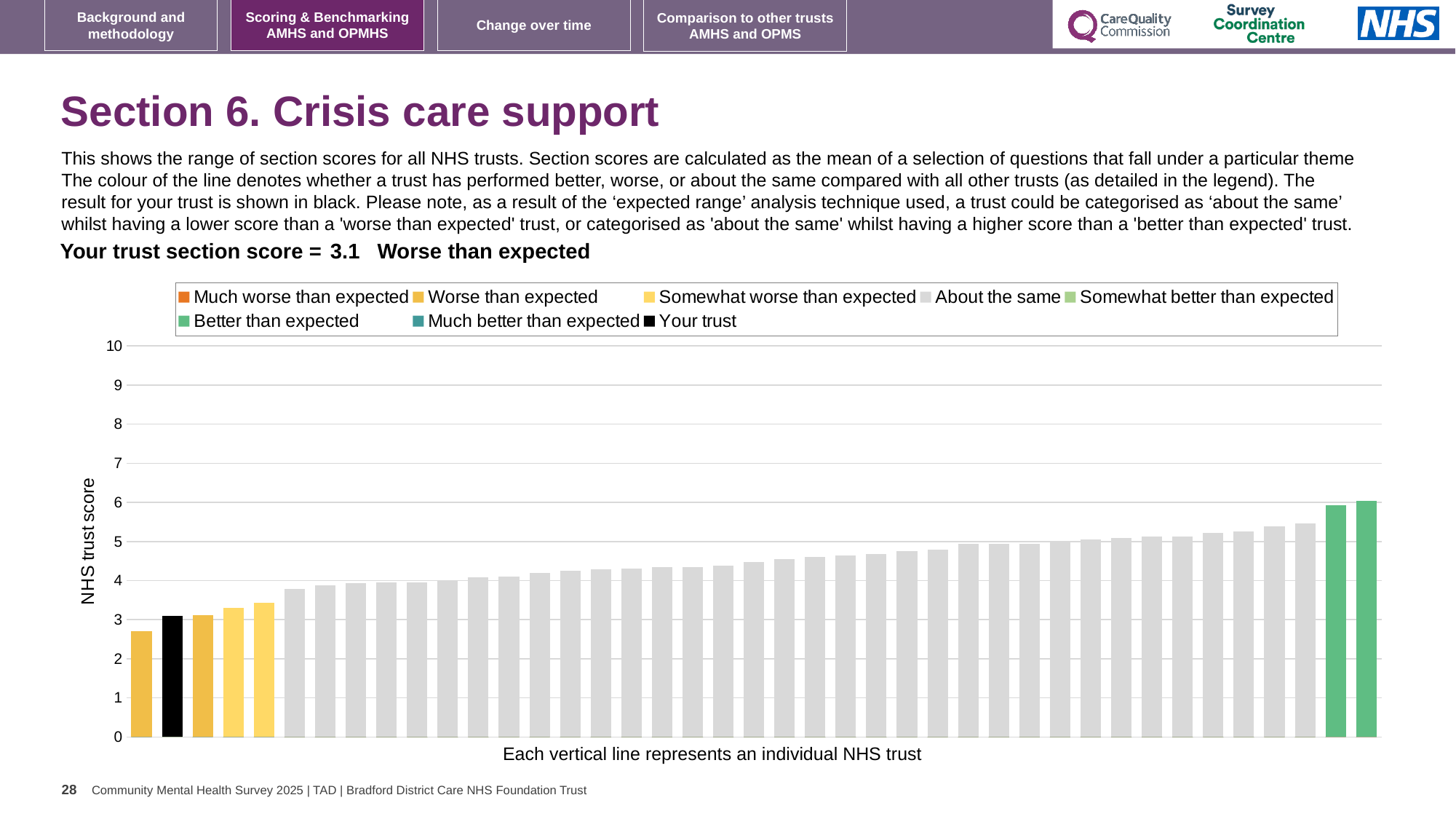
What kind of chart is shown on the slide? bar chart Is the value of the tallest bar greater or less than 5? greater What is the label on the vertical axis of the chart? NHS trust score How many entries does the chart legend list? 8 What is the section score for your trust shown on the slide? 3.1 Which legend category do the two tallest bars belong to? Better than expected How many bars are coloured as 'Better than expected' (green)? 2 What is the highest value shown on the vertical axis? 10 Do the bar values rise or fall from left to right along the x axis? rise Is the value of the leftmost (lowest) bar greater or less than 3? less Is the value of the black 'Your trust' bar greater or less than 4? less Which category is your trust's section score placed in? Worse than expected